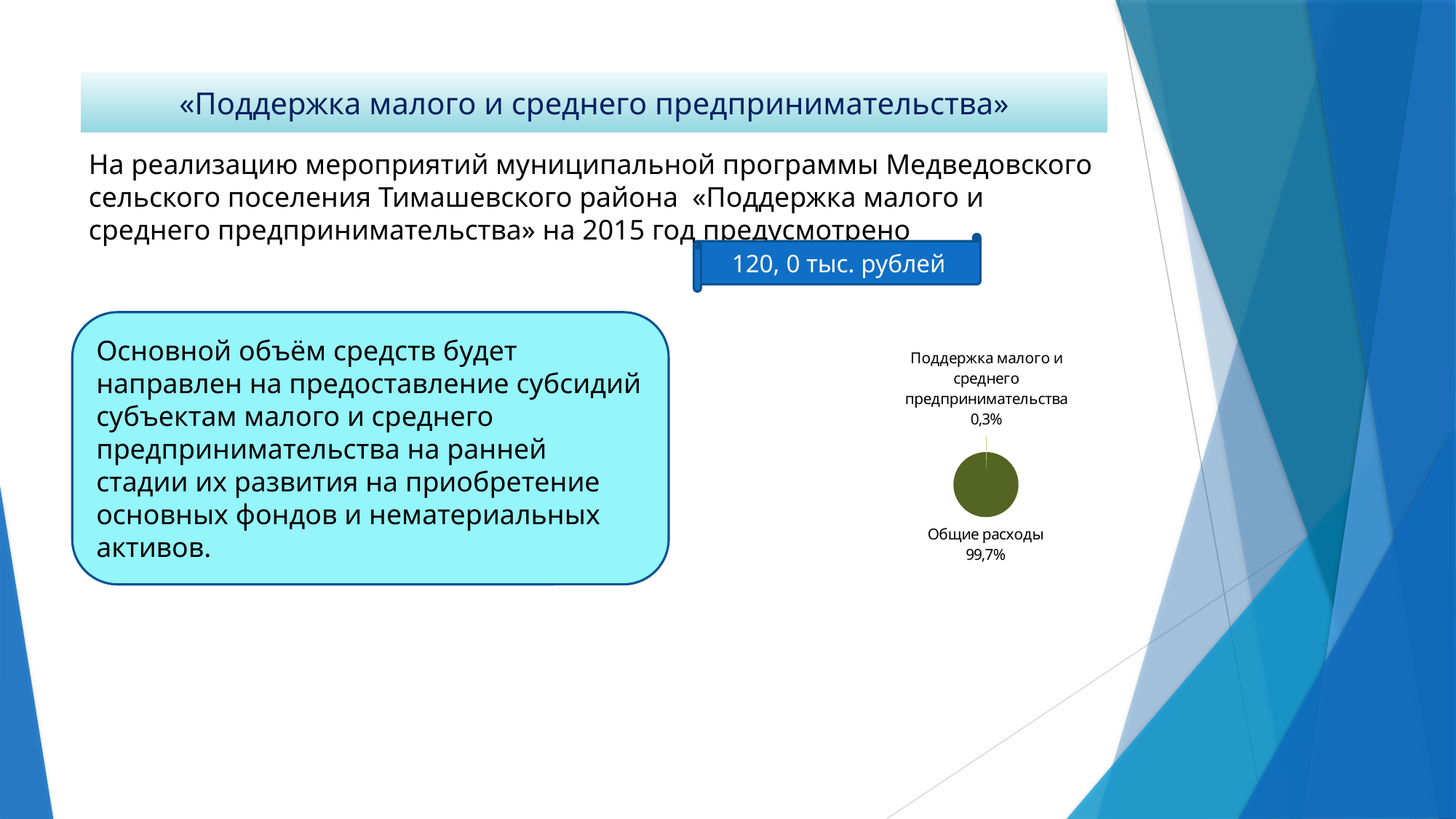
Which slice of the pie chart is the smallest? Поддержка малого и среднего предпринимательства What share of the pie does "Поддержка малого и среднего предпринимательства" represent? 0,3% What colour is the pie chart? dark olive green What kind of chart is shown on the slide? pie chart How many slices does the pie chart have? 2 What is the difference in percentage points between the "Общие расходы" slice and the "Поддержка малого и среднего предпринимательства" slice? 99,4 What is the total of the two percentages shown on the pie chart? 100% Which is larger in the pie chart: "Общие расходы" or "Поддержка малого и среднего предпринимательства"? Общие расходы What share of the pie does "Общие расходы" represent? 99,7% Which slice of the pie chart is the largest? Общие расходы